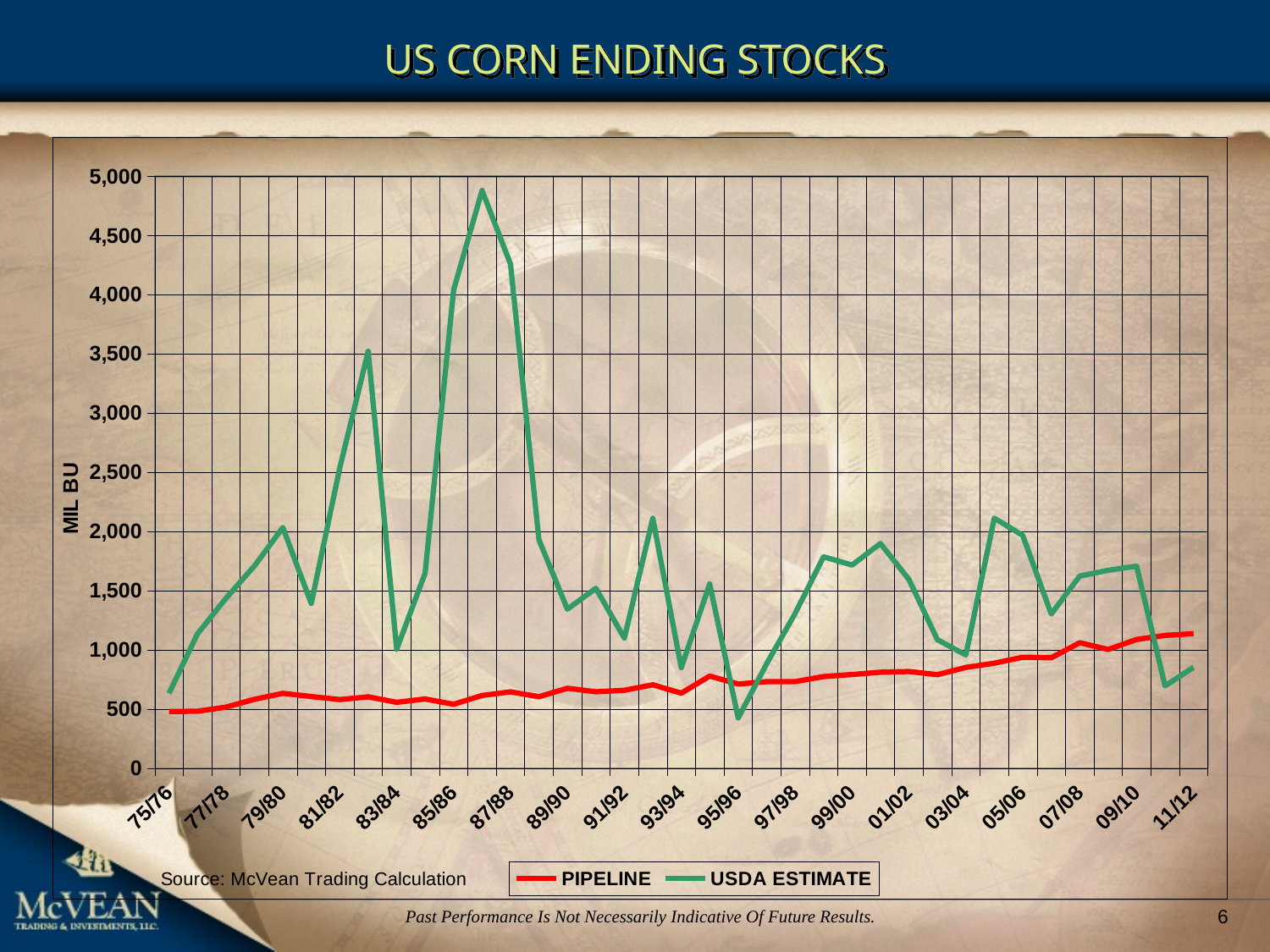
Which series has the larger value in 87/88, PIPELINE or USDA ESTIMATE? USDA ESTIMATE How many series does the legend list? 2 Is the USDA ESTIMATE value for 87/88 greater or less than 4,500? less What is the label on the vertical axis? MIL BU What is the title of the chart? US CORN ENDING STOCKS In which year does the USDA ESTIMATE series reach its highest value? 86/87 Which series has the larger value in 11/12, PIPELINE or USDA ESTIMATE? PIPELINE Is the PIPELINE value for 11/12 greater or less than 1,000? greater In which year does the USDA ESTIMATE series reach its lowest value? 95/96 Does the PIPELINE series generally rise or fall from 75/76 to 11/12? rise What type of chart is shown on the slide? line chart Is the USDA ESTIMATE value for 95/96 greater or less than 1,000? less